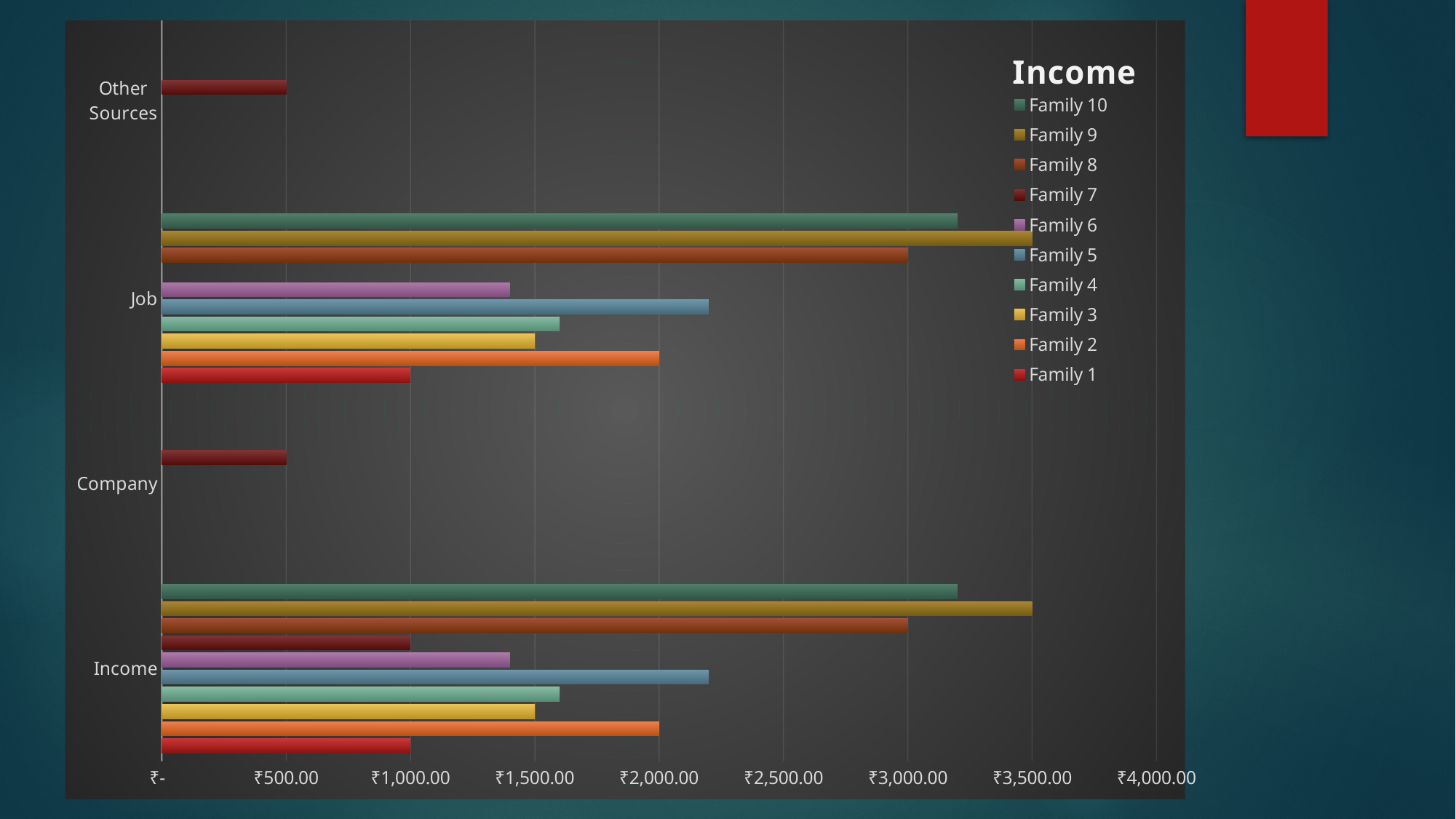
In the Job category, which is larger: Family 8 or Family 5? Family 8 What is the difference between Family 9 and Family 8 in the Job category? ₹500.00 How many series does the legend list? 10 What is the value for Family 9 in the Job category? ₹3,500.00 What kind of chart is shown on the slide? bar chart Is the value for Family 5 in the Income category greater or less than ₹2,000.00? greater What is the title of the chart? Income Which family has the highest value in the Job category? Family 9 How many categories are shown on the vertical axis? 4 Which family has the lowest value in the Job category? Family 7 What is the value for Family 7 in the Other Sources category? ₹500.00 Is the value for Family 10 in the Job category greater or less than ₹3,000.00? greater